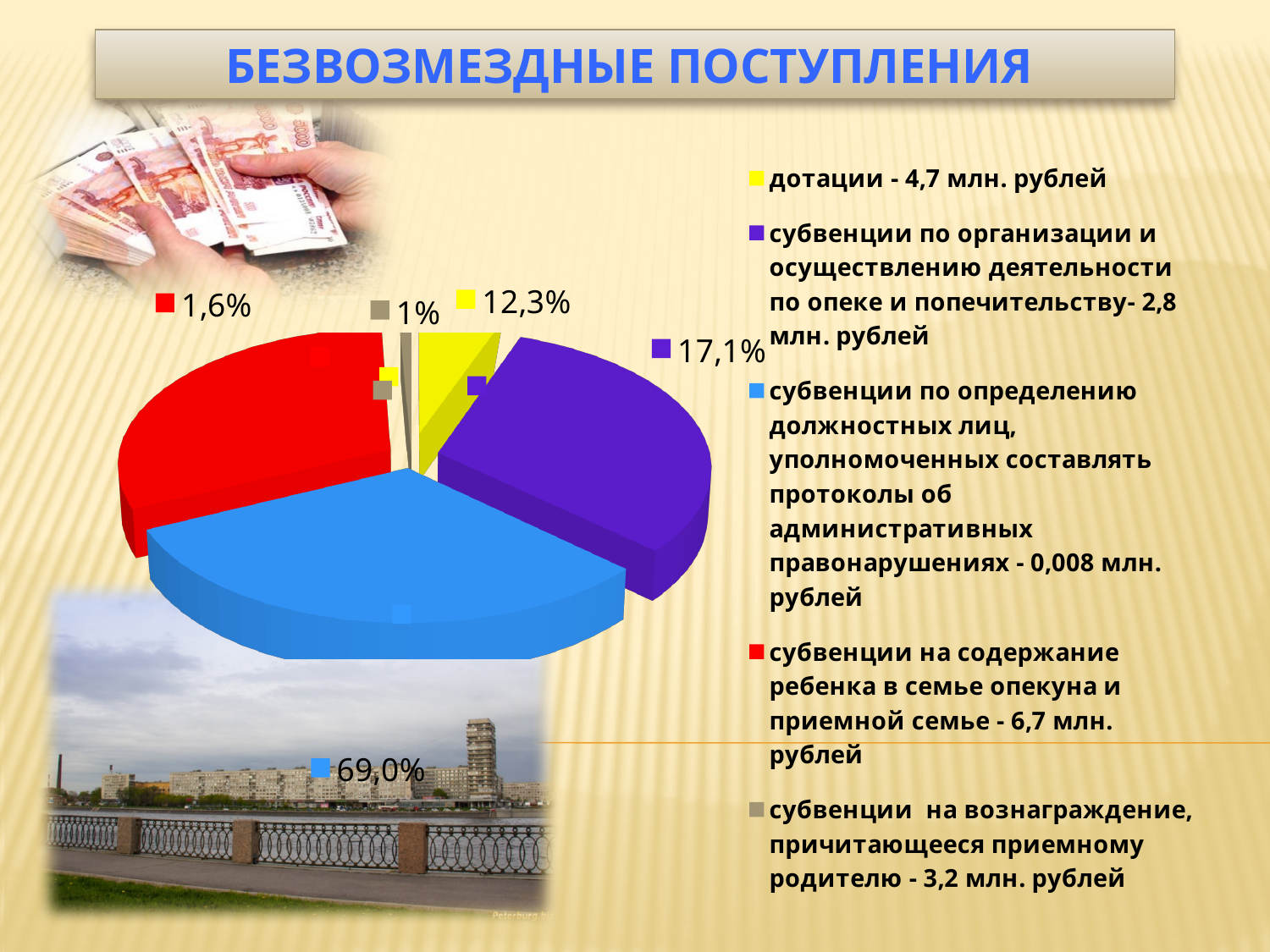
What is the title of the slide with the pie chart? БЕЗВОЗМЕЗДНЫЕ ПОСТУПЛЕНИЯ What kind of chart is shown on the slide? pie chart Which slice of the pie chart is the smallest? the grey slice, 1% What percentage is shown for the purple slice (субвенции по организации и осуществлению деятельности по опеке и попечительству)? 17,1% What percentage is shown for the yellow slice (дотации)? 12,3% Which slice of the pie chart is the largest? the blue slice, 69,0% What percentage is shown for the grey slice (субвенции на вознаграждение, причитающееся приемному родителю)? 1% What is the difference in percentage points between the blue slice (69,0%) and the purple slice (17,1%)? 51,9% How many slices does the pie chart have? 5 What percentage is shown for the red slice (субвенции на содержание ребенка в семье опекуна и приемной семье)? 1,6% What percentage is shown for the blue slice (субвенции по определению должностных лиц)? 69,0% How many entries does the legend of the pie chart list? 5